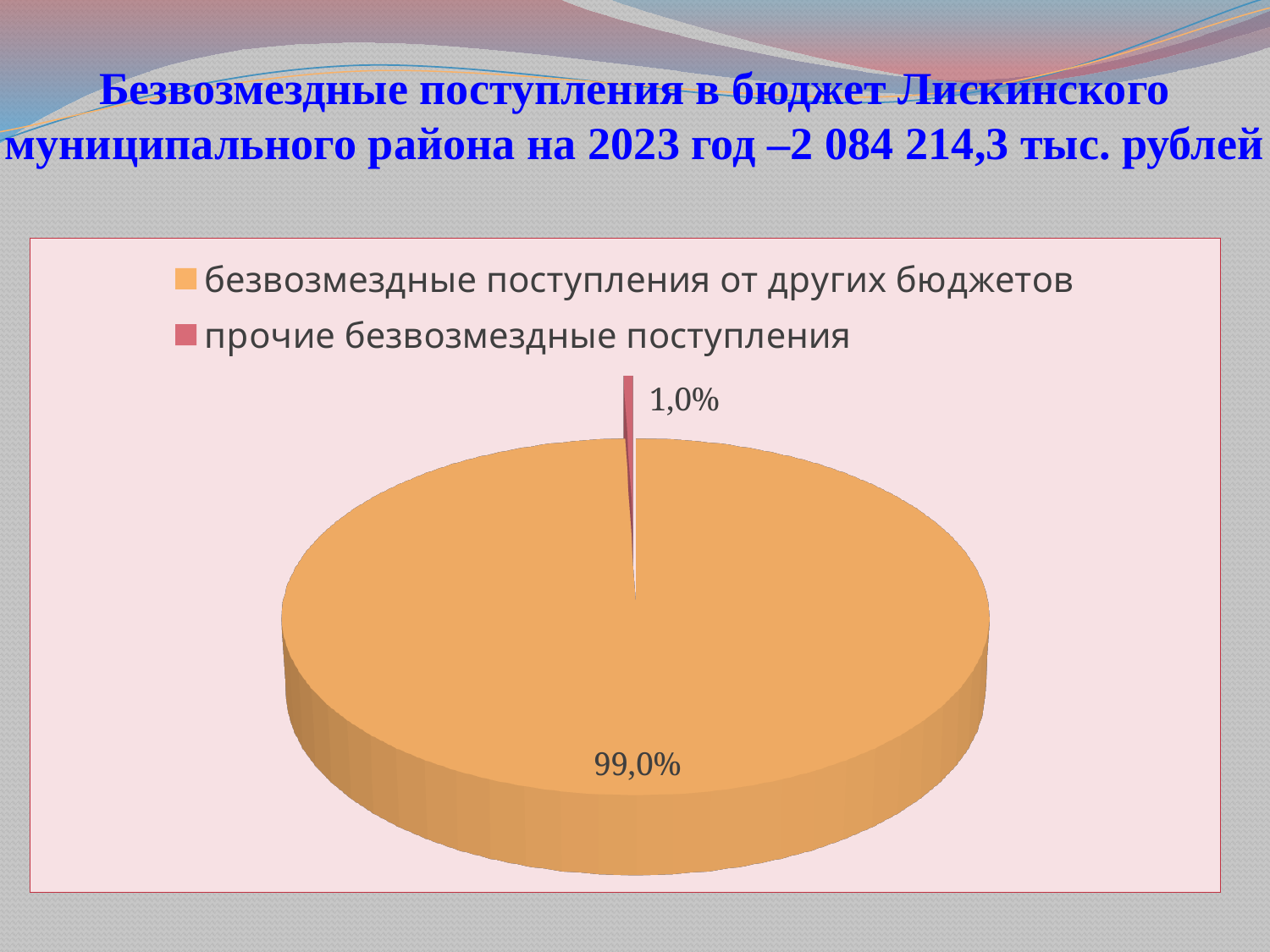
How many slices does the pie chart have? 2 What total amount of gratuitous receipts for 2023 is stated in the slide title? 2 084 214,3 тыс. рублей What share of the pie is 'прочие безвозмездные поступления'? 1,0% What is the difference in percentage points between the share of 'безвозмездные поступления от других бюджетов' and 'прочие безвозмездные поступления'? 98,0% What colour is the slice for 'прочие безвозмездные поступления'? red Which is larger: the share of 'прочие безвозмездные поступления' or the share of 'безвозмездные поступления от других бюджетов'? безвозмездные поступления от других бюджетов What share of the pie is 'безвозмездные поступления от других бюджетов'? 99,0% Which category has the smallest share of the pie? прочие безвозмездные поступления How many entries does the legend list? 2 Which category has the largest share of the pie? безвозмездные поступления от других бюджетов What kind of chart is shown on the slide? pie chart